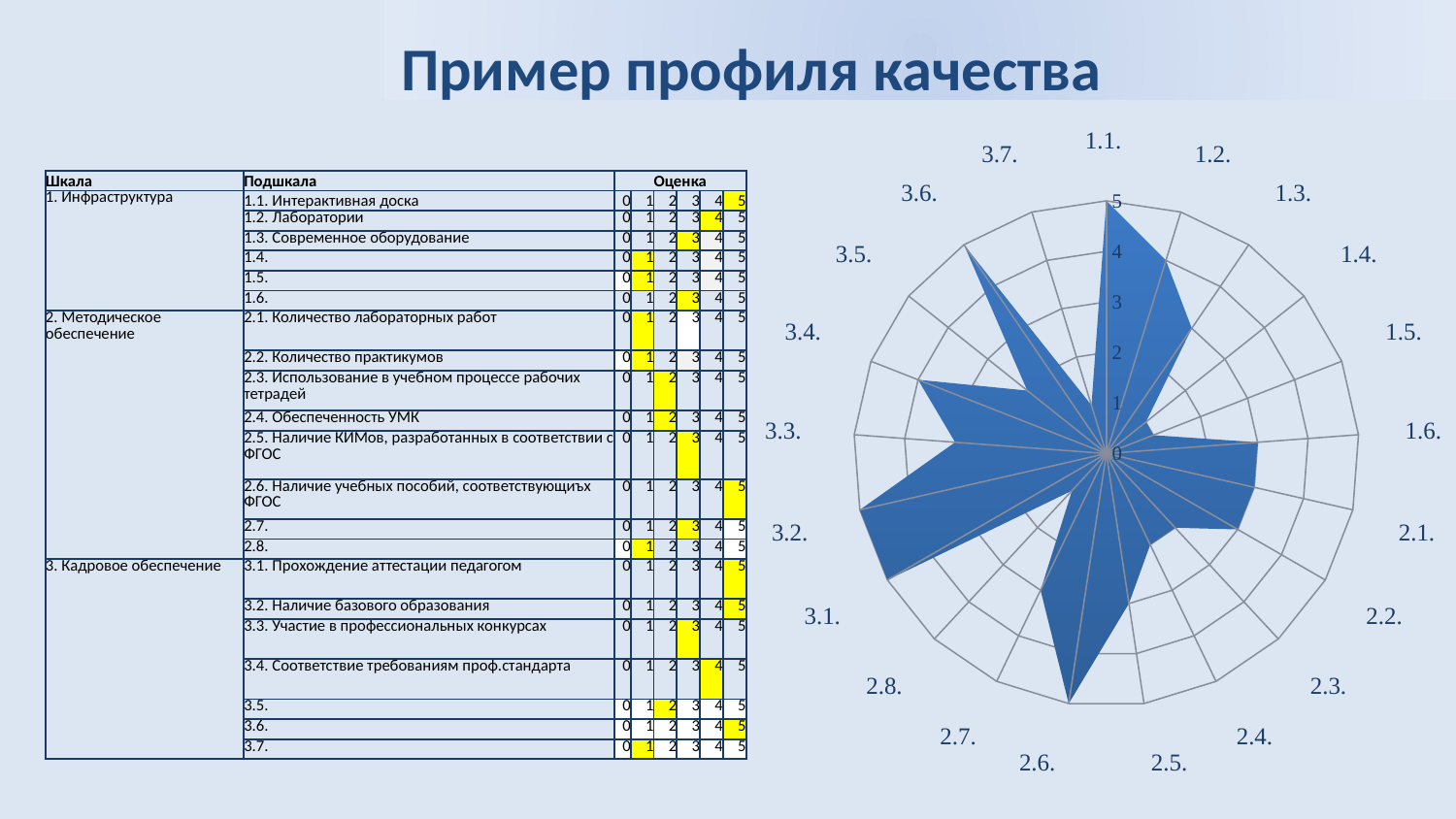
Is the value for 1.1. on the radar chart greater or less than 4? greater Is the value for 1.4. on the radar chart greater or less than 2? less Which has the larger value on the radar chart, 1.1. or 1.4.? 1.1. What is the highest value marked on the radar chart's axis? 5 Which has the larger value on the radar chart, 2.6. or 2.8.? 2.6. How many categories (subscales) are plotted around the radar chart? 21 Which has the larger value on the radar chart, 3.6. or 3.5.? 3.6. What is the title of the slide containing the radar chart? Пример профиля качества Is the value for 3.4. on the radar chart greater or less than 3? greater What kind of chart is shown on the slide? radar chart